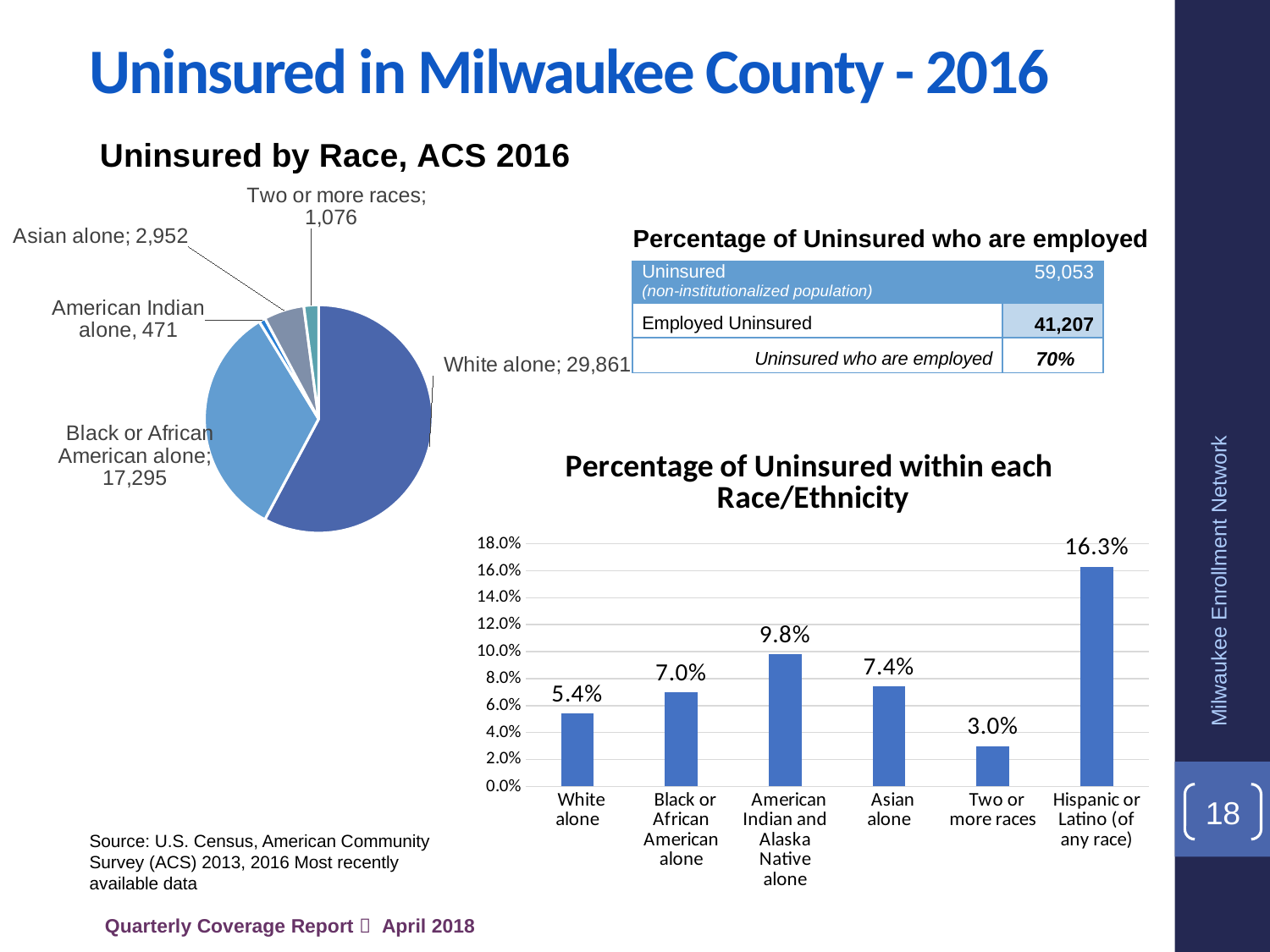
In the 'Percentage of Uninsured within each Race/Ethnicity' bar chart, what is the difference between the values for Hispanic or Latino (of any race) and White alone? 10.9 percentage points In the 'Uninsured by Race, ACS 2016' pie chart, which category has the smallest slice? American Indian alone In the 'Percentage of Uninsured within each Race/Ethnicity' bar chart, what is the value for Hispanic or Latino (of any race)? 16.3% How many categories are shown in the 'Percentage of Uninsured within each Race/Ethnicity' bar chart? 6 In the 'Percentage of Uninsured within each Race/Ethnicity' bar chart, which is larger: the value for Asian alone or for Black or African American alone? Asian alone In the 'Uninsured by Race, ACS 2016' pie chart, what is the value for Black or African American alone? 17,295 In the 'Percentage of Uninsured within each Race/Ethnicity' bar chart, which category has the highest value? Hispanic or Latino (of any race) What kind of chart is 'Percentage of Uninsured within each Race/Ethnicity'? Bar chart In the 'Percentage of Uninsured within each Race/Ethnicity' bar chart, which category has the lowest value? Two or more races How many slices does the 'Uninsured by Race, ACS 2016' pie chart have? 5 In the 'Uninsured by Race, ACS 2016' pie chart, which category has the largest slice? White alone In the 'Uninsured by Race, ACS 2016' pie chart, what is the difference between the values for White alone and Black or African American alone? 12,566